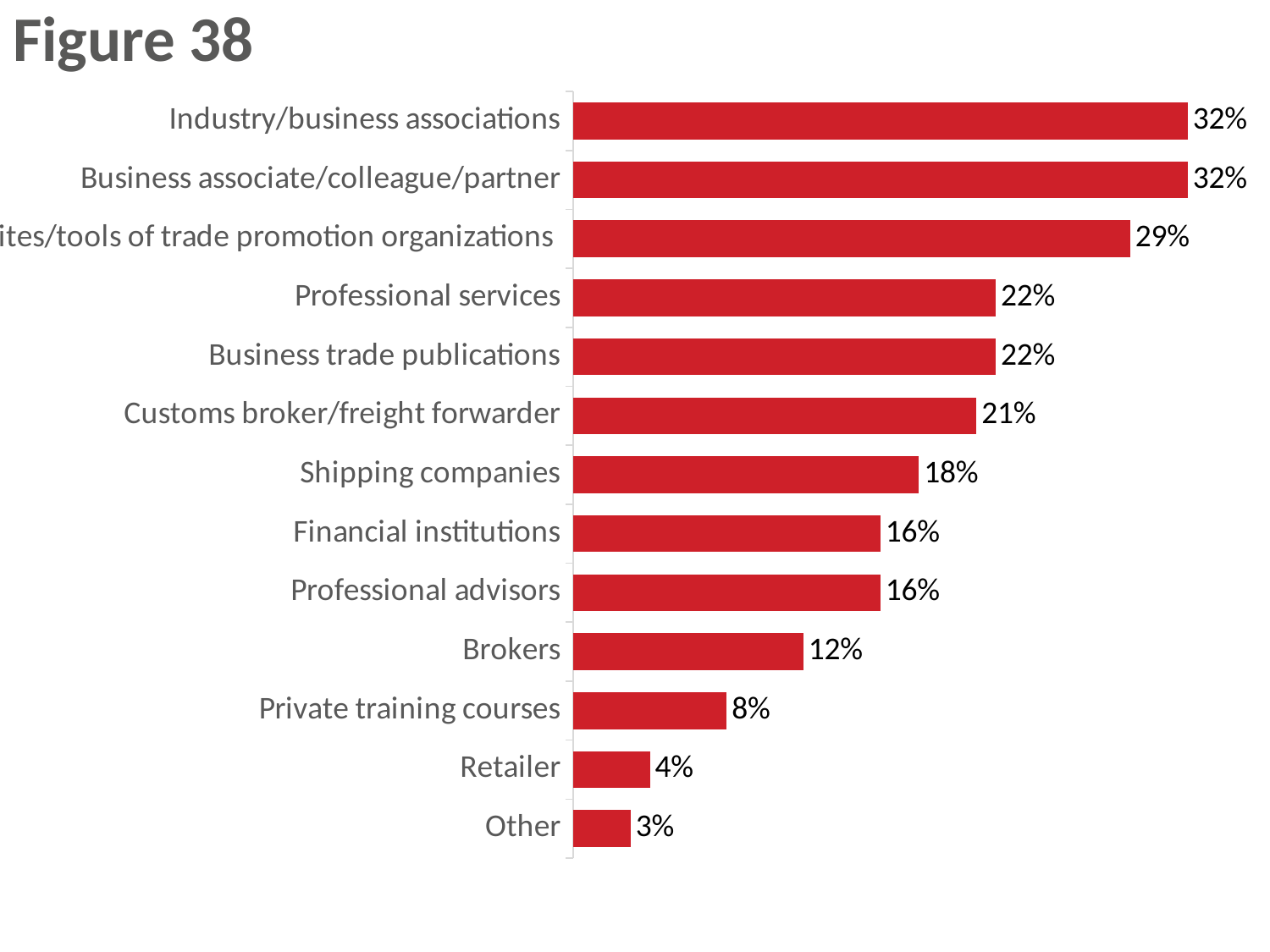
Which is larger, the value for Retailer or the value for Other? Retailer What is the difference between the values for Financial institutions and Retailer? 12% What is the value for Shipping companies? 18% What is the value for Customs broker/freight forwarder? 21% What is the title of the slide? Figure 38 What is the value for Private training courses? 8% What is the difference between the values for Industry/business associations and Professional services? 10% Which category has the lowest value? Other Which is larger, the value for Business trade publications or the value for Shipping companies? Business trade publications How many categories are shown in the chart? 13 What is the value for Brokers? 12% What kind of chart is shown on the slide? Bar chart